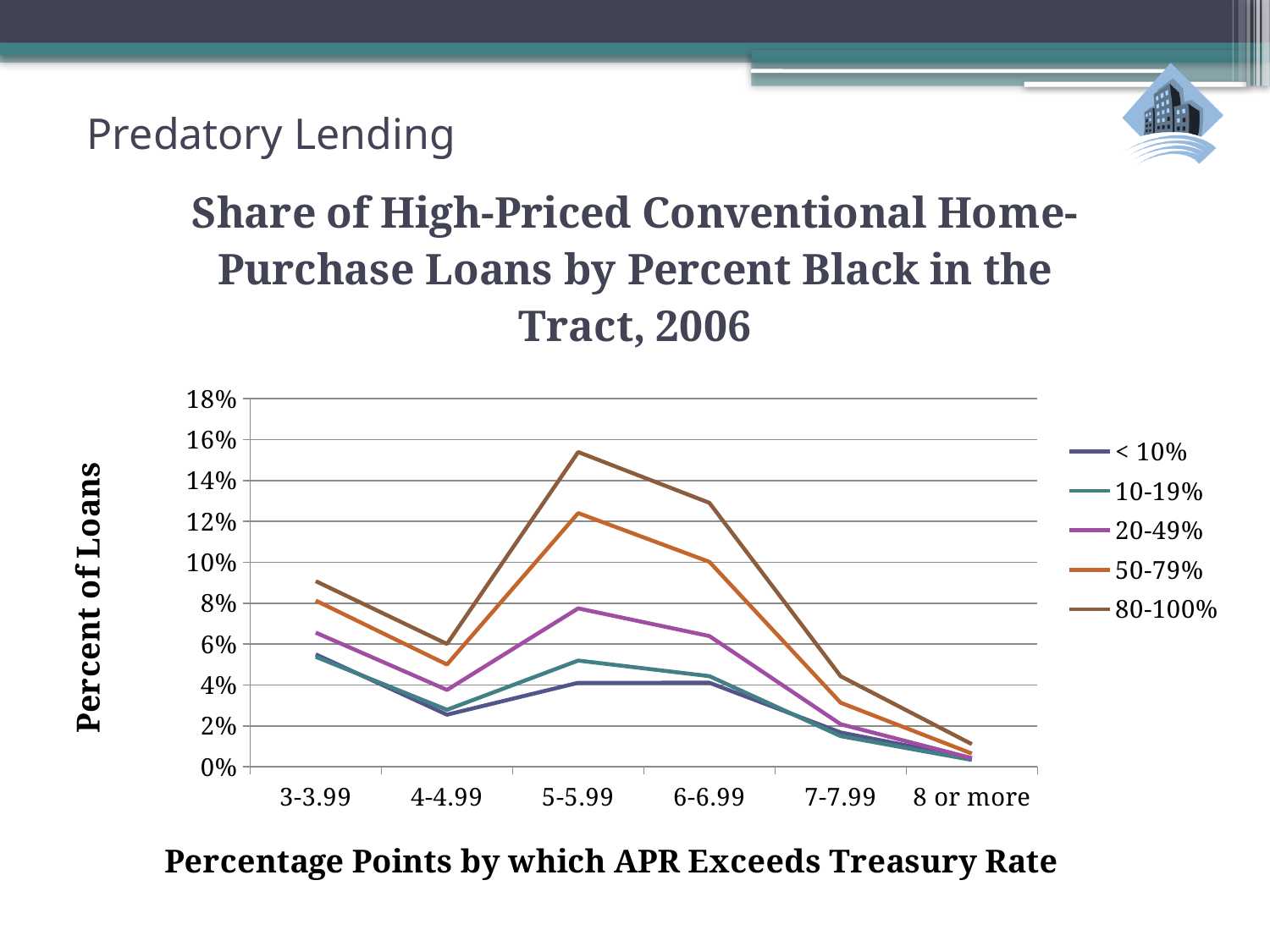
Do the values for the 80-100% series rise or fall from 6-6.99 to 8 or more? fall What is the title of the y axis? Percent of Loans For the 80-100% series, which x-axis category has the highest value? 5-5.99 What kind of chart is shown on the slide? line chart Is the value for the 20-49% series at 7-7.99 greater or less than 4%? less Is the value for the 50-79% series at 5-5.99 greater or less than 10%? greater For the 80-100% series, which x-axis category has the lowest value? 8 or more How many series does the legend list? 5 How many categories are shown along the x axis? 6 What is the title of the x axis? Percentage Points by which APR Exceeds Treasury Rate Is the value for the 80-100% series at 5-5.99 greater or less than 14%? greater At 6-6.99, which series has the larger value: 80-100% or 50-79%? 80-100%